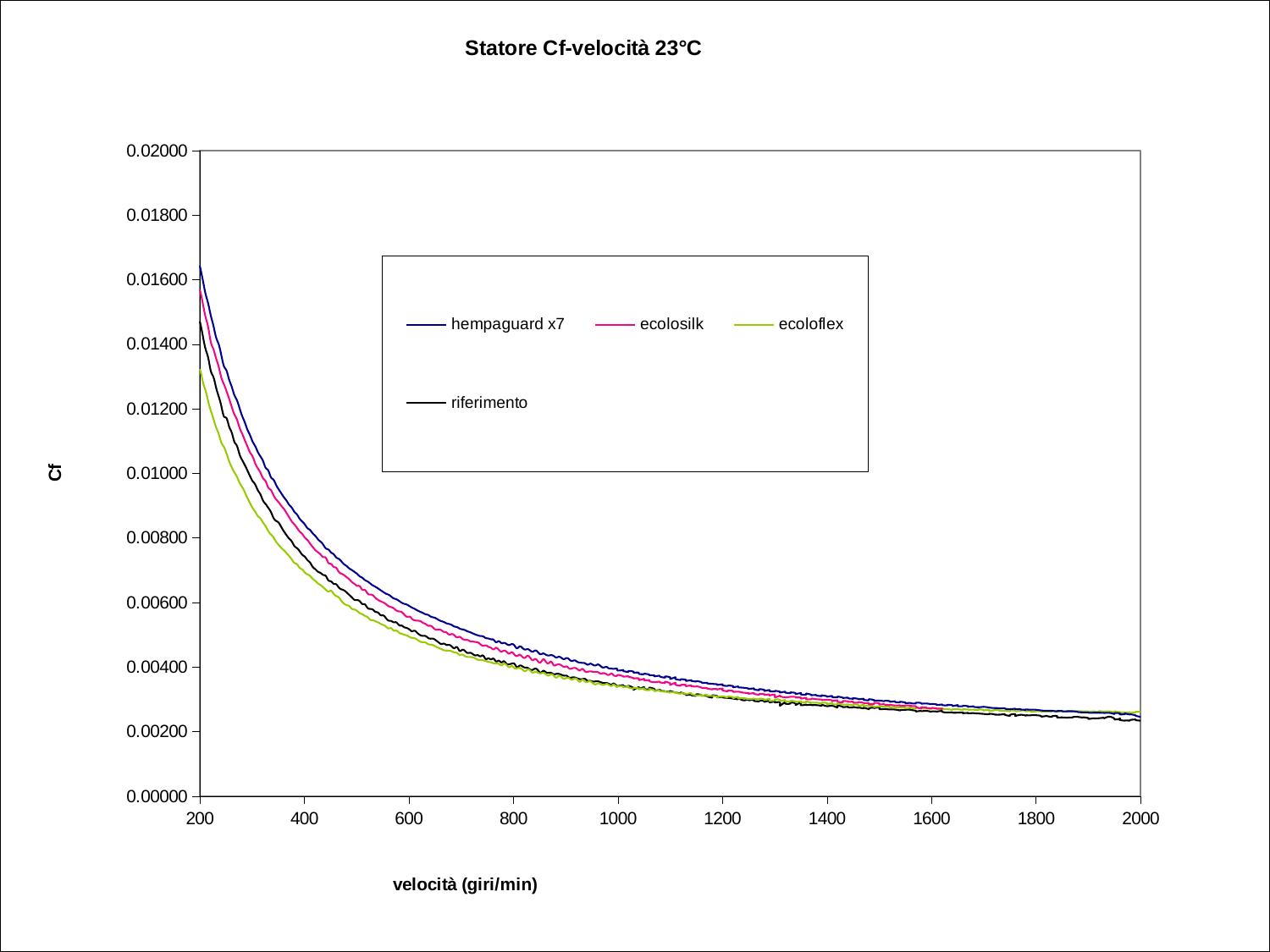
Which series has the highest Cf value at velocità 200 giri/min? hempaguard x7 Is the Cf value for hempaguard x7 at 200 giri/min greater or less than 0.01400? greater Which series has the lowest Cf value at velocità 200 giri/min? ecoloflex What kind of chart is shown on the slide? line chart How many series does the legend list? 4 Is the Cf value for hempaguard x7 at 400 giri/min greater or less than 0.00600? greater What is the label of the x axis? velocità (giri/min) Do the Cf values rise or fall as velocità increases along the x axis? fall What is the title of the chart? Statore Cf-velocità 23°C Is the Cf value for riferimento at 1000 giri/min greater or less than 0.00600? less At 200 giri/min, which series has the larger Cf value, ecolosilk or riferimento? ecolosilk